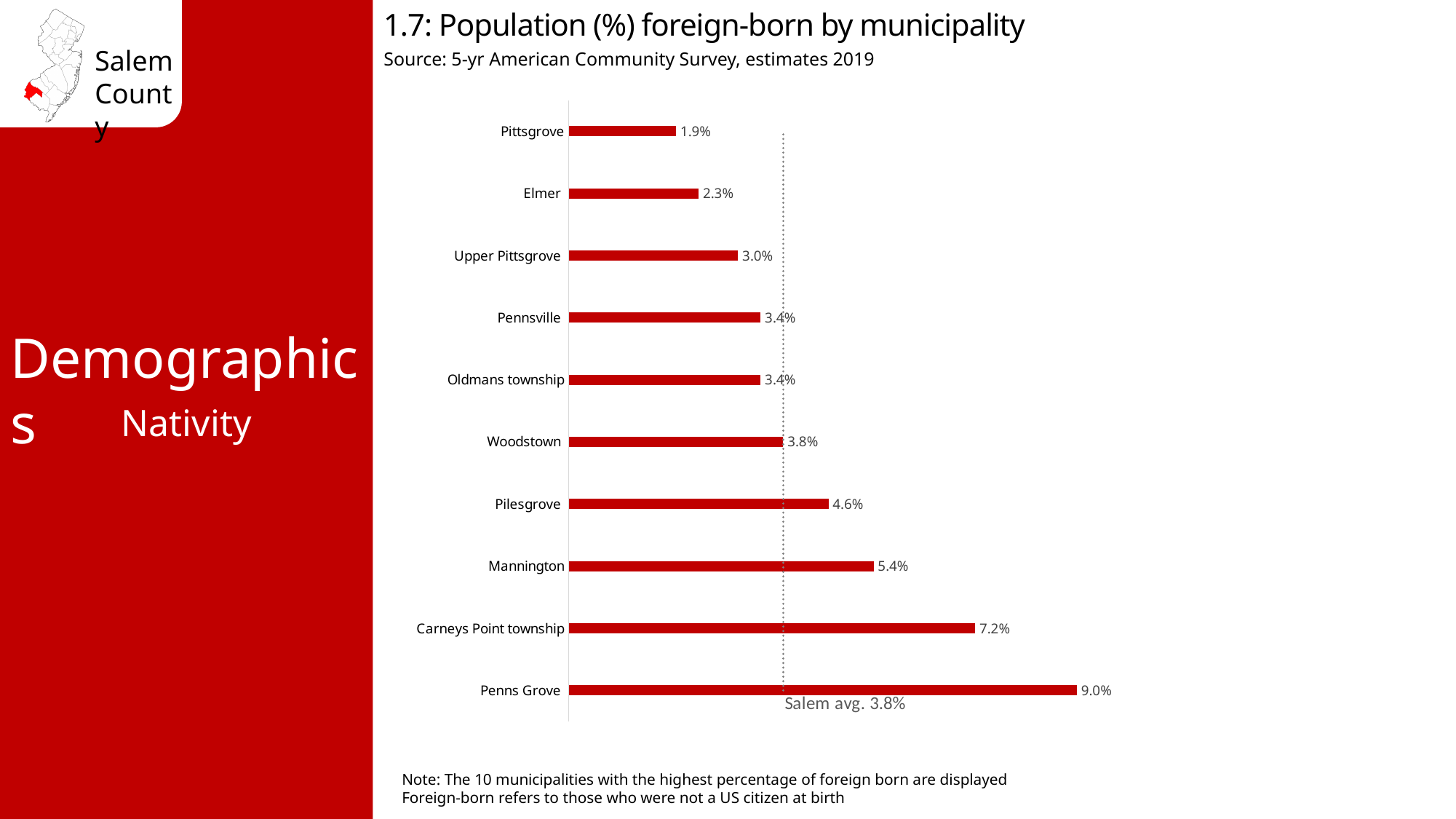
What is the source of the data shown in the chart? 5-yr American Community Survey, estimates 2019 What is the difference between the foreign-born percentages of Penns Grove and Carneys Point township? 1.8% How many municipalities are shown in the chart? 10 What is the foreign-born population percentage for Mannington? 5.4% What is the difference between the foreign-born percentages of Pilesgrove and Woodstown? 0.8% What is the foreign-born population percentage for Elmer? 2.3% What type of chart is used to show the foreign-born population by municipality? Bar chart What is the foreign-born population percentage for Penns Grove? 9.0% Which municipality has the highest percentage of foreign-born population? Penns Grove Which municipality has the lowest percentage of foreign-born population? Pittsgrove Which has a higher foreign-born percentage, Upper Pittsgrove or Mannington? Mannington What is the Salem County average foreign-born percentage indicated by the dotted line? 3.8%